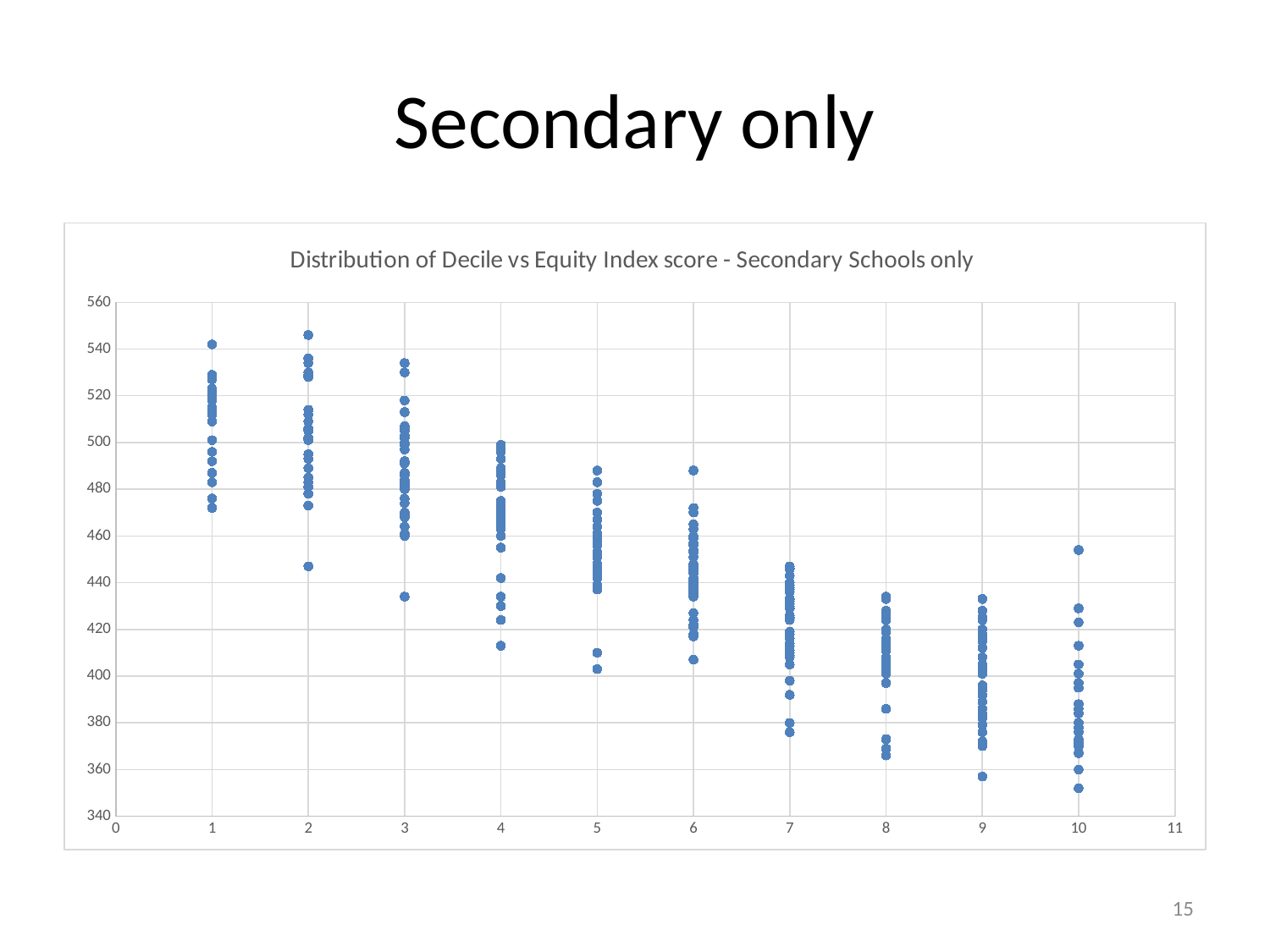
Which decile has the highest plotted Equity Index score? 2 Is the highest point for decile 7 greater or less than 460? less What kind of chart is shown on the slide? Scatter plot As the decile increases from 1 to 10, do the Equity Index scores generally rise or fall? Fall What is the title of the chart? Distribution of Decile vs Equity Index score - Secondary Schools only How many deciles have data points plotted on the chart? 10 What is the maximum value shown on the vertical axis? 560 Is the lowest point for decile 8 greater or less than 360? greater Is the lowest point for decile 3 greater or less than 440? less